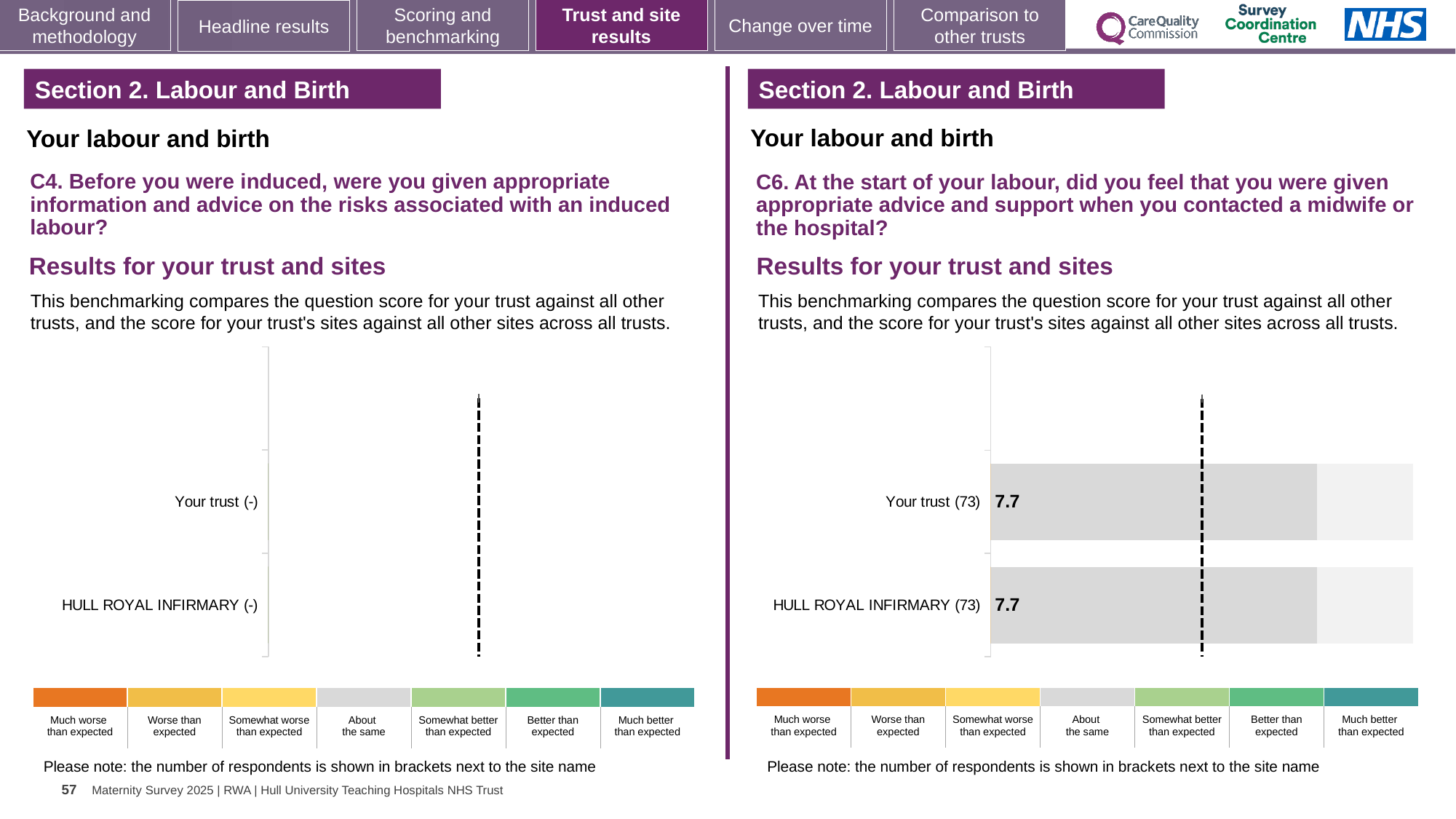
How many categories (rows) are plotted in the C6 chart on the right? 2 In the C6 chart on the right, what is the difference between the score for Your trust and the score for HULL ROYAL INFIRMARY? 0 How many categories (rows) are listed in the C4 chart on the left? 2 In the C6 chart on the right, what is the score for Your trust? 7.7 What kind of chart is the C6 chart on the right? Bar chart In the C6 chart on the right, how many respondents are shown in brackets next to HULL ROYAL INFIRMARY? 73 In the C6 chart on the right, how many respondents are shown in brackets next to Your trust? 73 In the C6 chart on the right, what is the score for HULL ROYAL INFIRMARY? 7.7 In the C4 chart on the left, what is shown in brackets next to Your trust? - How many rating bands does the colour key below the C6 chart on the right show? 7 In the colour key below the C4 chart on the left, which band is shown in grey? About the same